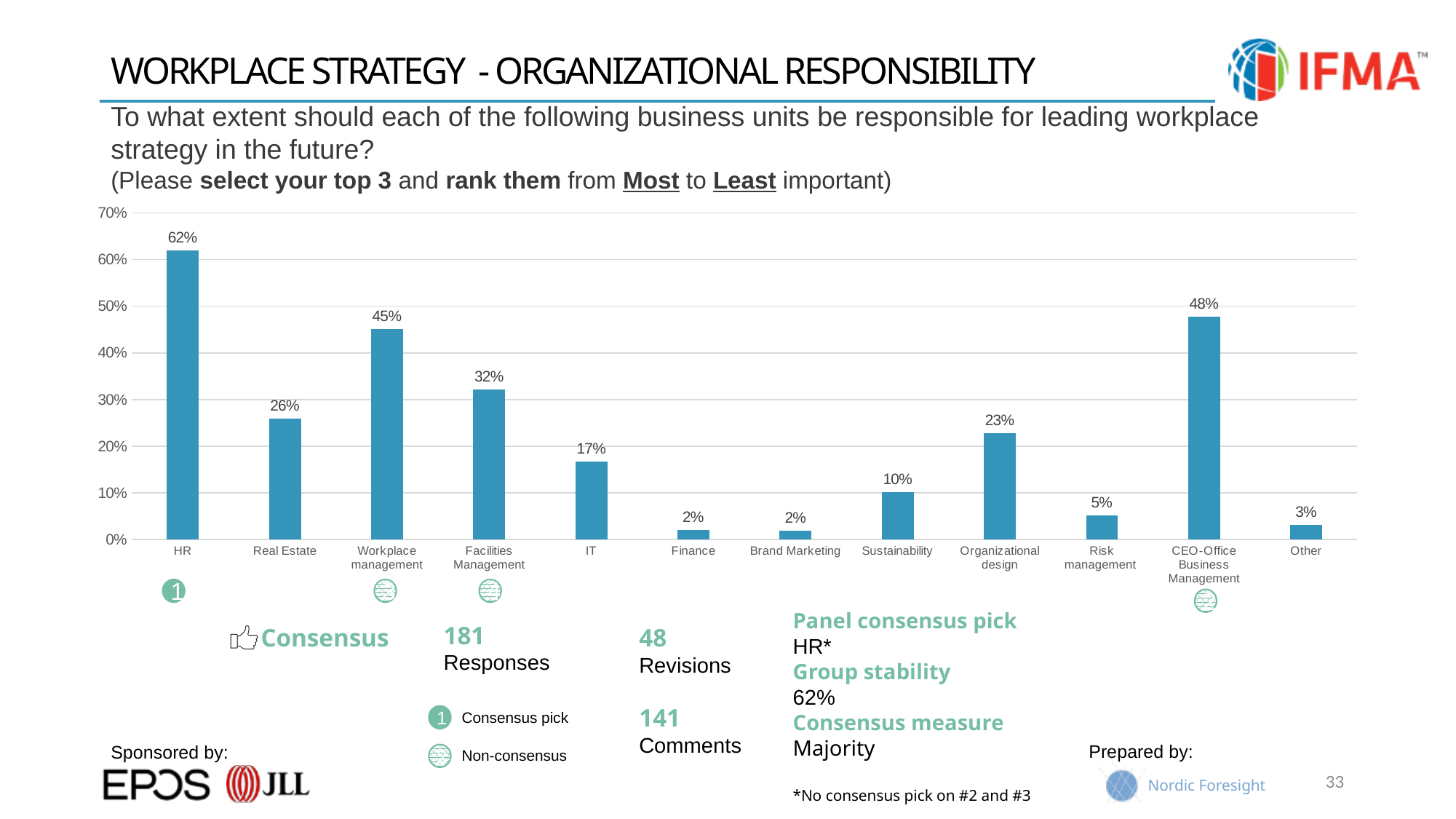
Which is larger, the value for Real Estate or the value for IT? Real Estate What kind of chart is shown on the slide? bar chart What is the value for HR? 62% What is the value for CEO-Office Business Management? 48% What is the value for Organizational design? 23% What is the value for Risk management? 5% Which category is marked with the consensus pick symbol below the chart? HR Which category has the highest value? HR Is the value for Sustainability greater or less than 20%? less What is the difference between the values for Workplace management and Facilities Management? 13% How many categories are shown on the x axis? 12 What is the difference between the values for HR and CEO-Office Business Management? 14%